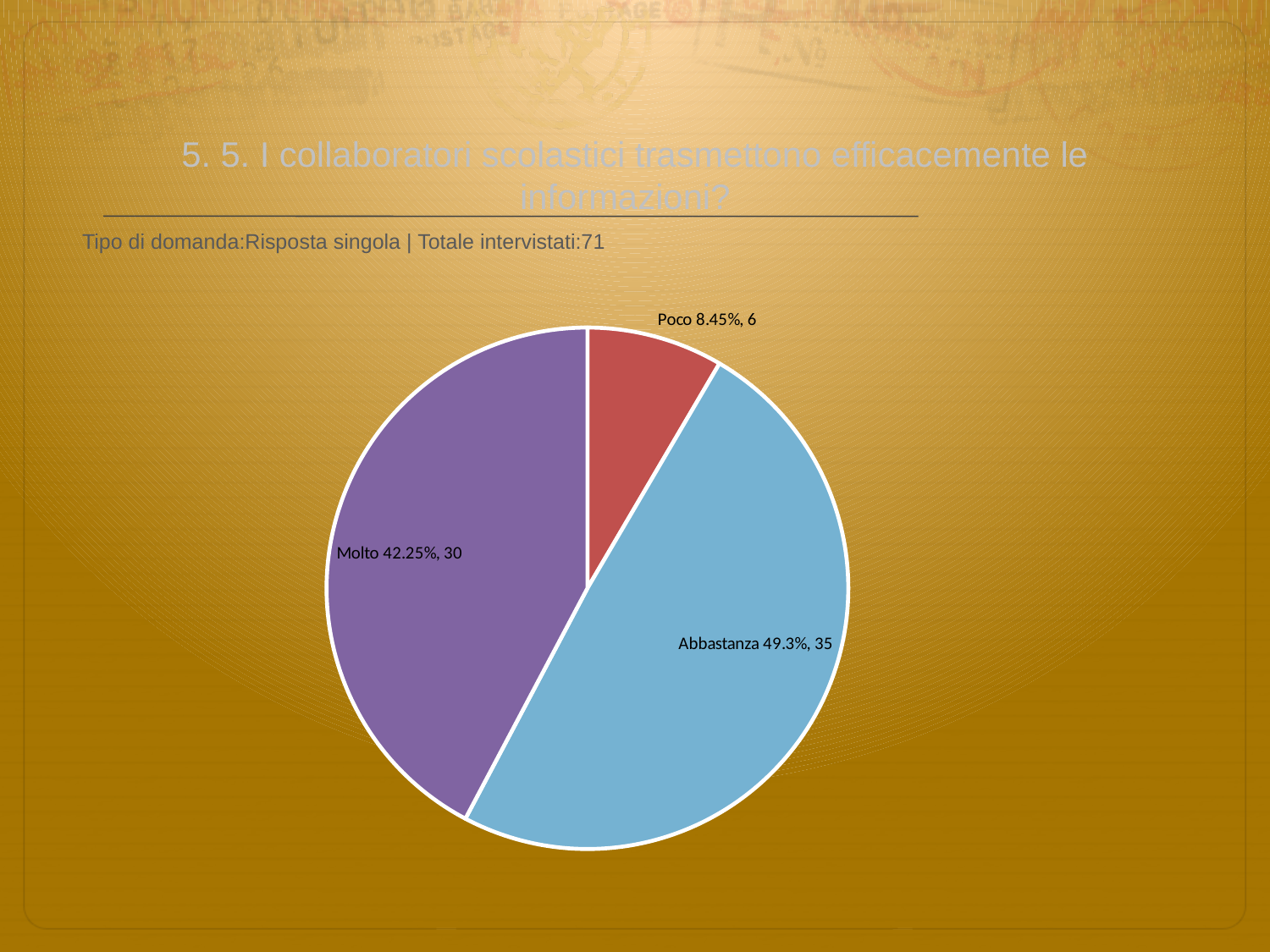
How many respondents answered Molto? 30 What percentage share does the Molto slice have? 42.25% What percentage share does the Poco slice have? 8.45% Which has more respondents, Molto or Poco? Molto What is the difference in respondent count between Abbastanza and Molto? 5 What colour is the Abbastanza slice? light blue What kind of chart is shown on the slide? pie chart Which category has the largest slice? Abbastanza How many slices does the pie chart have? 3 Which category has the smallest slice? Poco How many respondents answered Poco? 6 What percentage share does the Abbastanza slice have? 49.3%